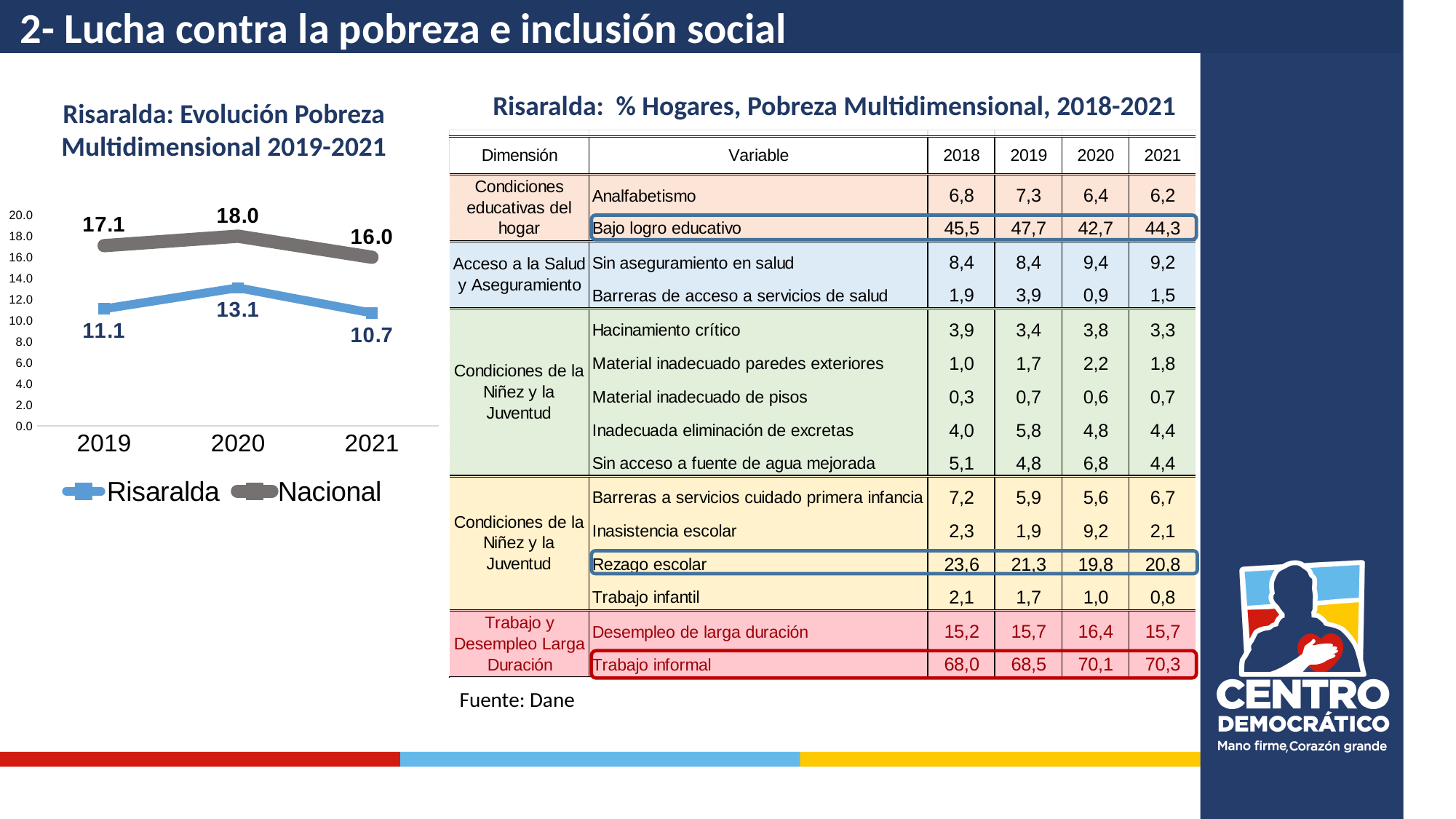
In which year is the Risaralda series lowest? 2021 How many series does the chart legend list? 2 What is the difference between the Nacional and Risaralda values in 2019? 6.0 What is the value for Risaralda in 2020? 13.1 What is the value for Nacional in 2021? 16.0 Does the Risaralda series rise or fall from 2020 to 2021? Fall In which year is the Nacional series highest? 2020 How many years are plotted on the x axis of the chart? 3 What type of chart is shown on the slide? Line chart What is the title of the line chart? Risaralda: Evolución Pobreza Multidimensional 2019-2021 What is the value for Risaralda in 2019? 11.1 Which series has the larger value in 2021, Risaralda or Nacional? Nacional